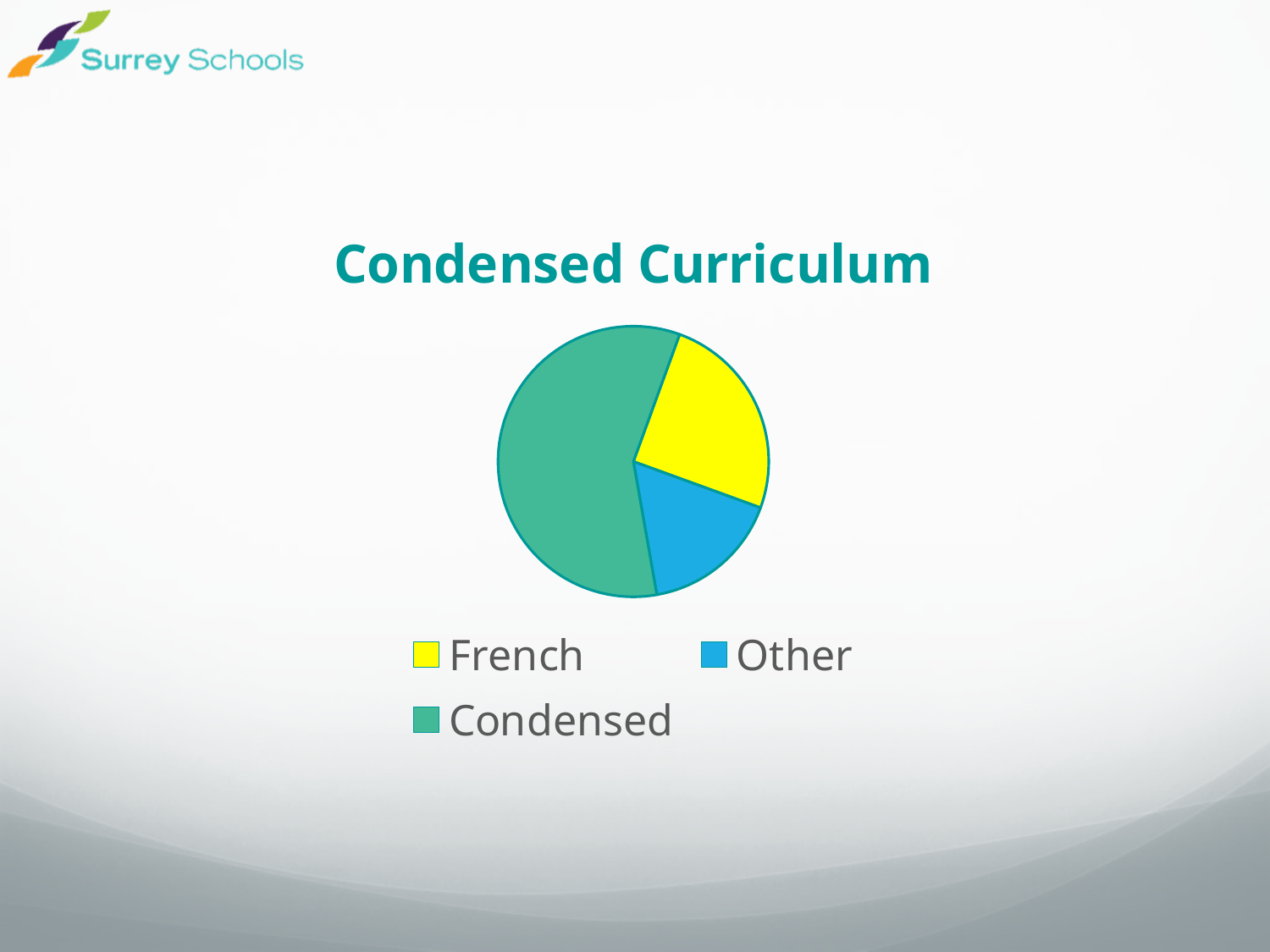
Which slice is smaller, Condensed or Other? Other How many entries does the legend list? 3 What is the title of the chart? Condensed Curriculum What colour is the French slice in the pie chart? yellow Which slice is larger, Condensed or French? Condensed Which category has the smallest slice of the pie? Other Which slice is larger, French or Other? French How many slices does the pie chart have? 3 Which category has the largest slice of the pie? Condensed What kind of chart is shown on the slide? pie chart